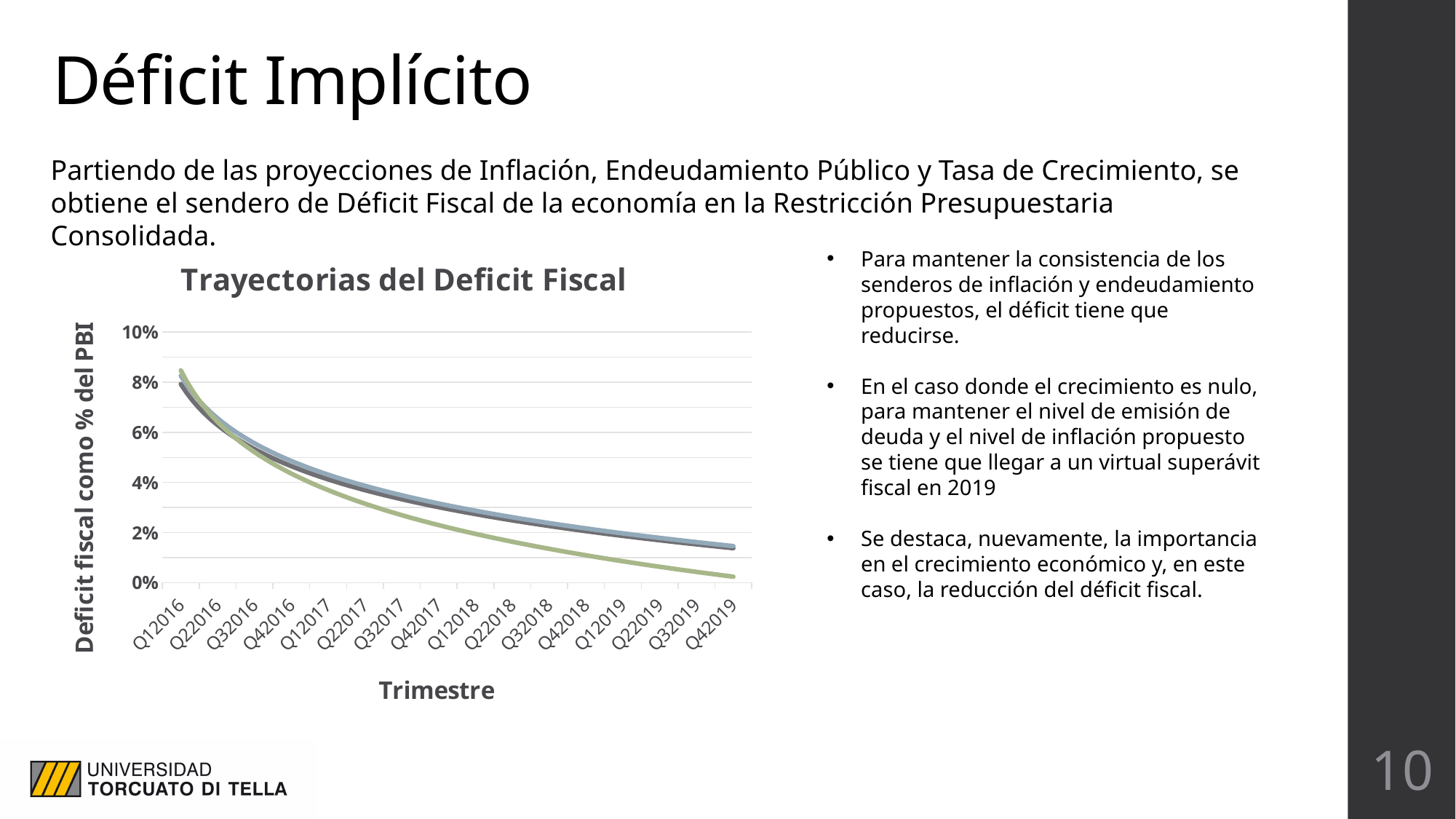
What is the label of the y axis of the chart? Deficit fiscal como % del PBI Is the value of the green line at Q12016 greater or less than 8%? greater How many quarters are shown along the x axis of the chart? 16 Is the value of the green line at Q42019 greater or less than 2%? less Is the value of the blue line at Q42019 greater or less than 2%? less What kind of chart is shown on the slide? line chart At which quarter does the green line reach its highest value? Q12016 Do the lines in the chart rise or fall from Q12016 to Q42019? fall What is the title of the chart? Trayectorias del Deficit Fiscal At Q42019, which line is higher, the green line or the blue line? blue line